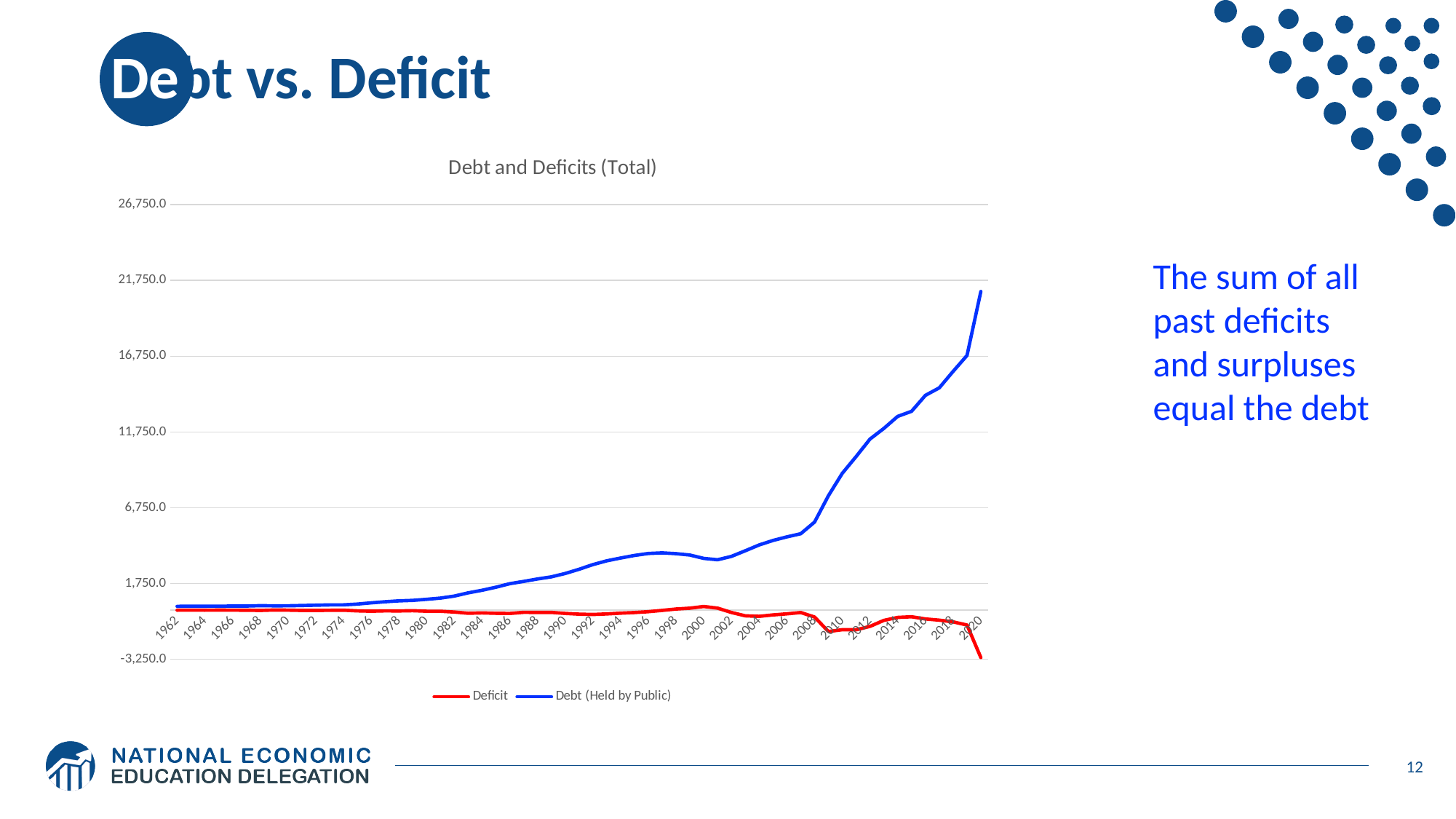
In 2020, which series has the larger value, Deficit or Debt (Held by Public)? Debt (Held by Public) Which series is drawn in blue? Debt (Held by Public) Is the value of Debt (Held by Public) in 2000 greater or less than 6,750.0? less In which year does the Debt (Held by Public) series reach its highest value? 2020 Does the Debt (Held by Public) series generally rise or fall from 1962 to 2020? rise How many series does the chart legend list? 2 Is the value of Debt (Held by Public) in 2010 greater or less than 6,750.0? greater In which year does the Deficit series reach its lowest value? 2020 How many year labels are shown on the x axis? 30 Is the value of Debt (Held by Public) in 2020 greater or less than 16,750.0? greater What type of chart is shown on the slide? line chart What is the title of the chart? Debt and Deficits (Total)